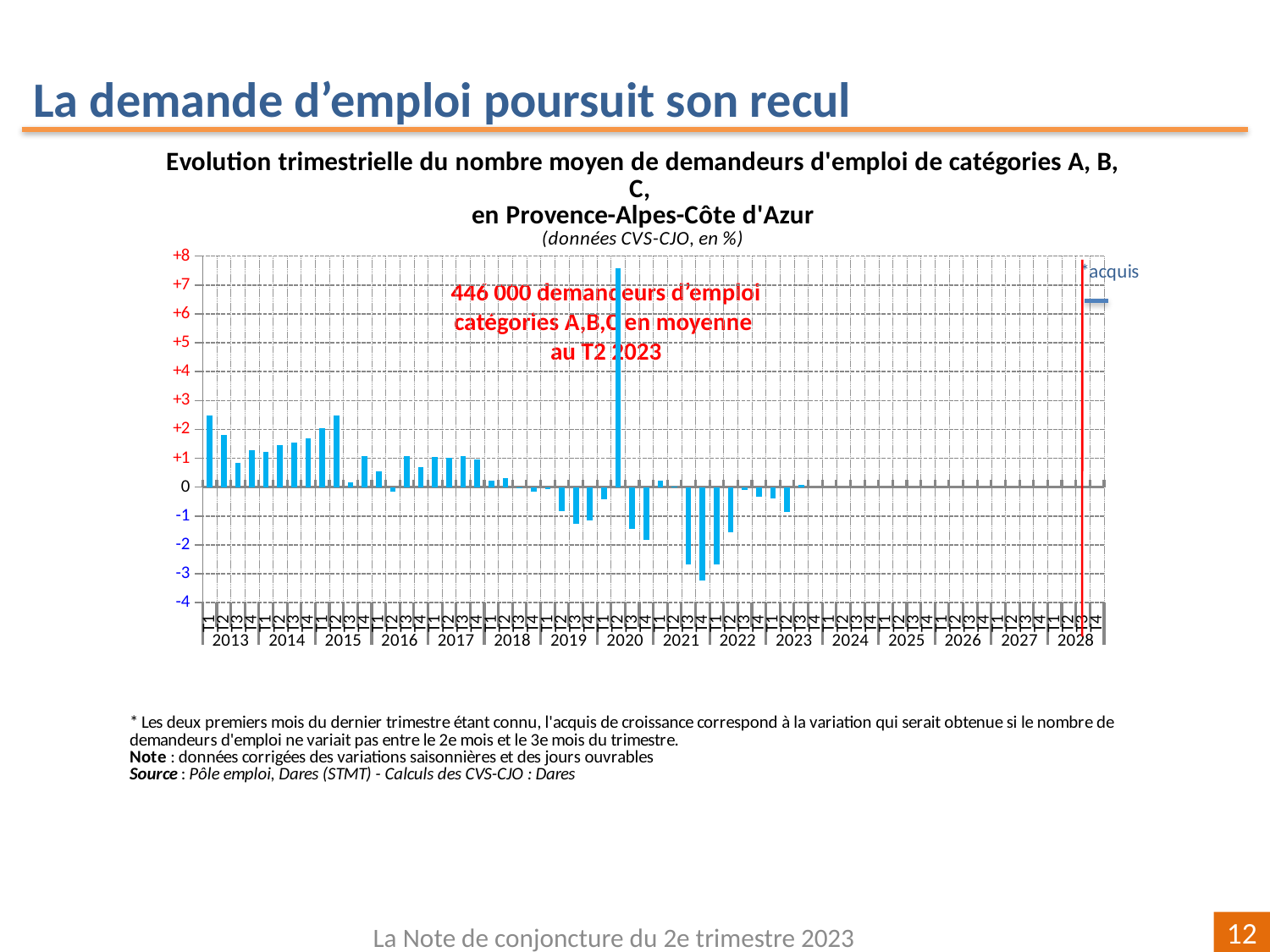
Are the bars for the quarters of 2013 positive or negative? positive Is the value for T1 2013 greater or less than +2? greater Which quarter has the highest value on the chart? T2 2020 What kind of chart is shown on the slide? bar chart How many years are labelled on the x axis? 16 Is the lowest bar on the chart greater or less than -3? less What is the highest value shown on the y axis? +8 Which is larger, the value for T2 2020 or the value for T1 2013? T2 2020 Is the value for T2 2020 greater or less than +7? greater Which is larger, the value for T1 2013 or the value for T2 2013? T1 2013 According to the annotation on the chart, how many demandeurs d'emploi catégories A,B,C were there on average in T2 2023? 446 000